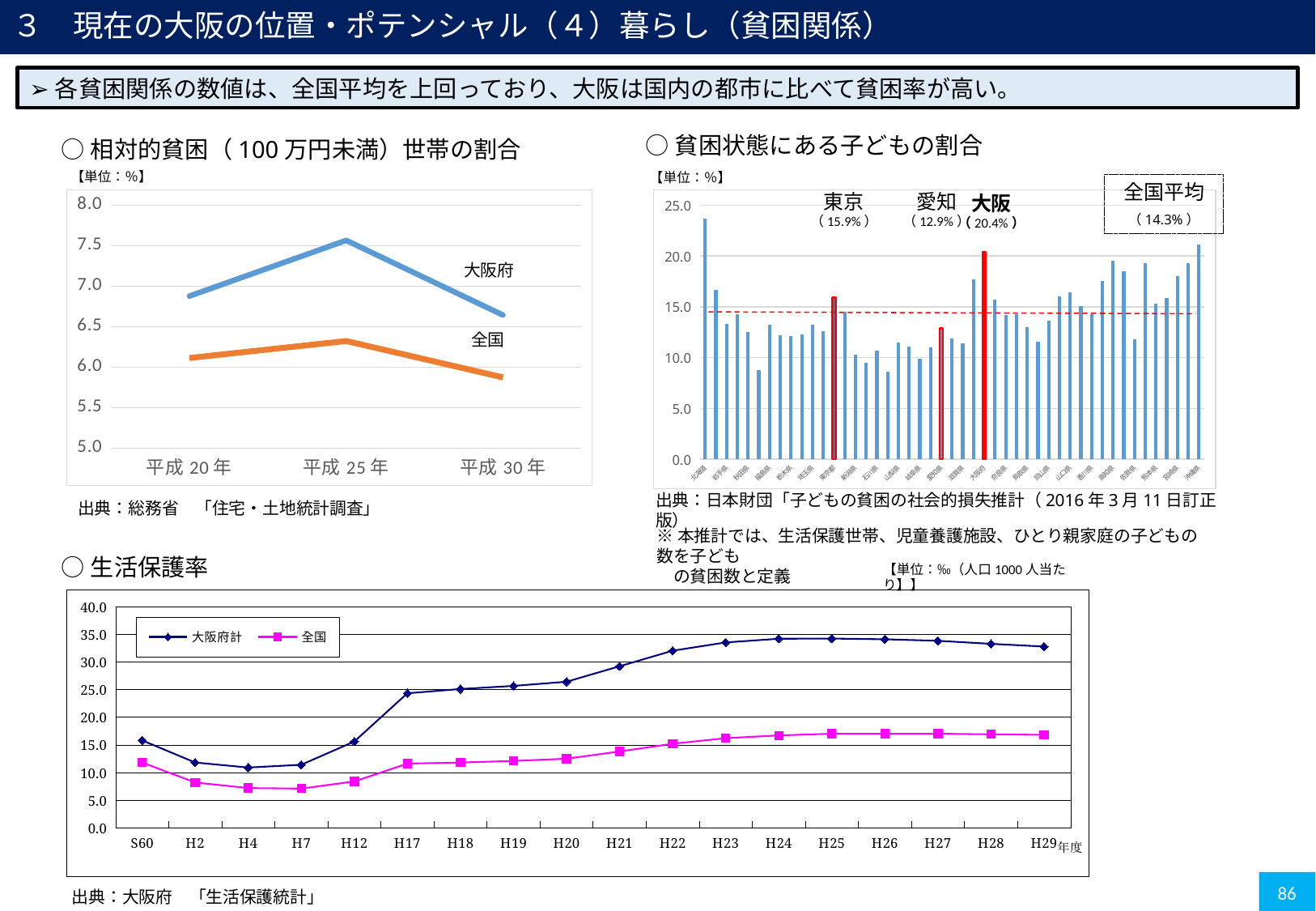
In the 貧困状態にある子どもの割合 chart, what is the value for 大阪? 20.4% In the 貧困状態にある子どもの割合 chart, what is the difference between the 大阪 value and the 東京 value? 4.5 percentage points In the 相対的貧困（100万円未満）世帯の割合 chart, which series is higher at 平成25年, 大阪府 or 全国? 大阪府 In the 貧困状態にある子どもの割合 chart, what is the 全国平均 value? 14.3% In the 生活保護率 chart, how many series does the legend list? 2 In the 相対的貧困（100万円未満）世帯の割合 chart, is the 全国 value for 平成30年 greater or less than 6.0? less In the 生活保護率 chart, is the 大阪府計 value for H24 greater or less than 30.0? greater In the 相対的貧困（100万円未満）世帯の割合 chart, how many series are plotted? 2 In the 貧困状態にある子どもの割合 chart, which is higher, 東京 or 愛知? 東京 In the 相対的貧困（100万円未満）世帯の割合 chart, how many years are shown on the x axis? 3 In the 相対的貧困（100万円未満）世帯の割合 chart, is the 大阪府 value for 平成25年 greater or less than 7.0? greater What kind of chart is the 貧困状態にある子どもの割合 chart? bar chart